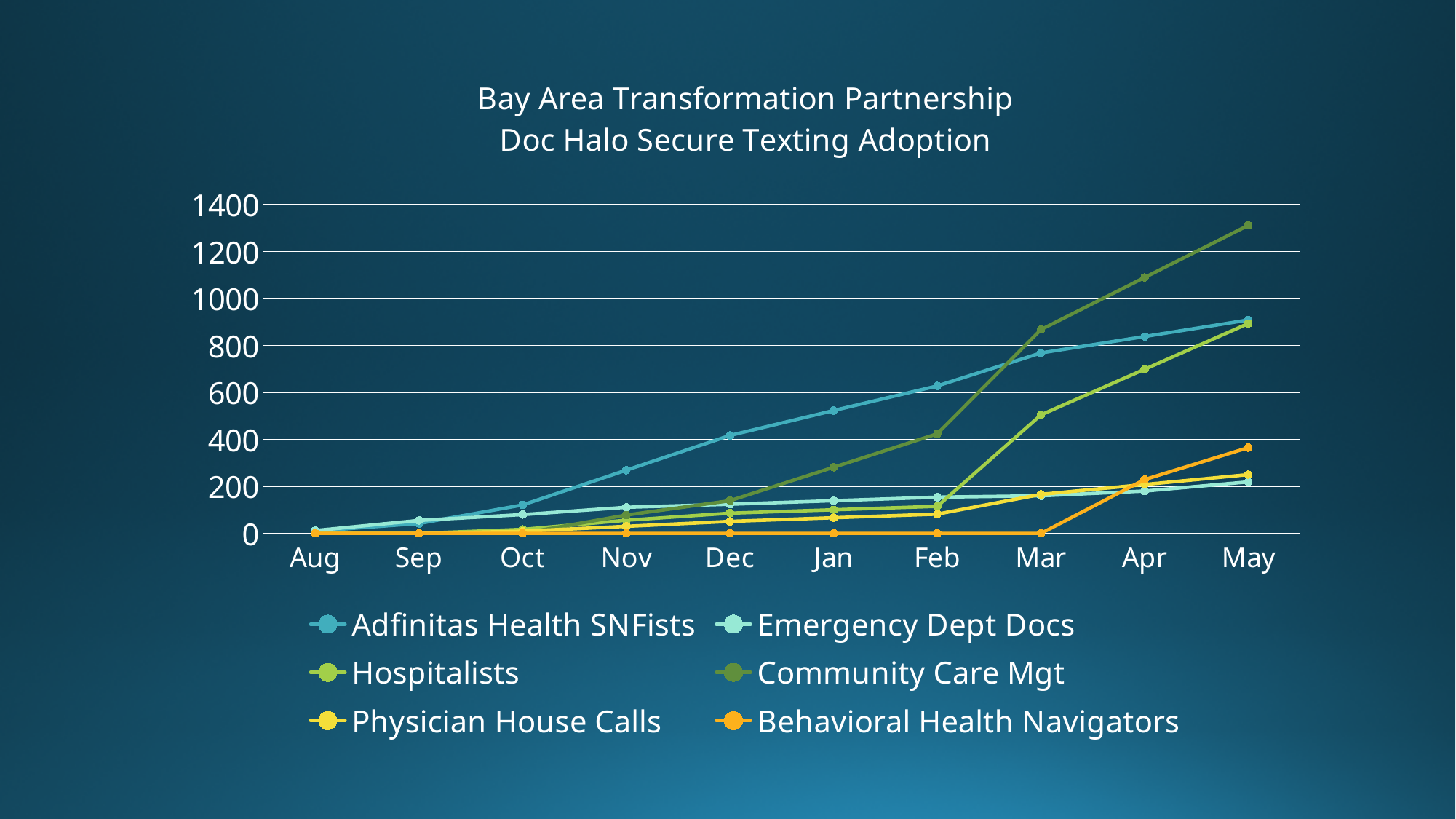
What is the title of the chart? Bay Area Transformation Partnership Doc Halo Secure Texting Adoption Is the value for Behavioral Health Navigators in May greater or less than 200? greater Which series has the lowest value in Mar? Behavioral Health Navigators What kind of chart is shown on the slide? line chart Is the value for Adfinitas Health SNFists in Mar greater or less than 600? greater Which series has the highest value in May? Community Care Mgt How many months are shown along the x axis? 10 How many series does the legend list? 6 In Jan, which is larger: Adfinitas Health SNFists or Community Care Mgt? Adfinitas Health SNFists Is the value for Community Care Mgt in May greater or less than 1200? greater Does the Community Care Mgt line rise or fall from Aug to May? rise